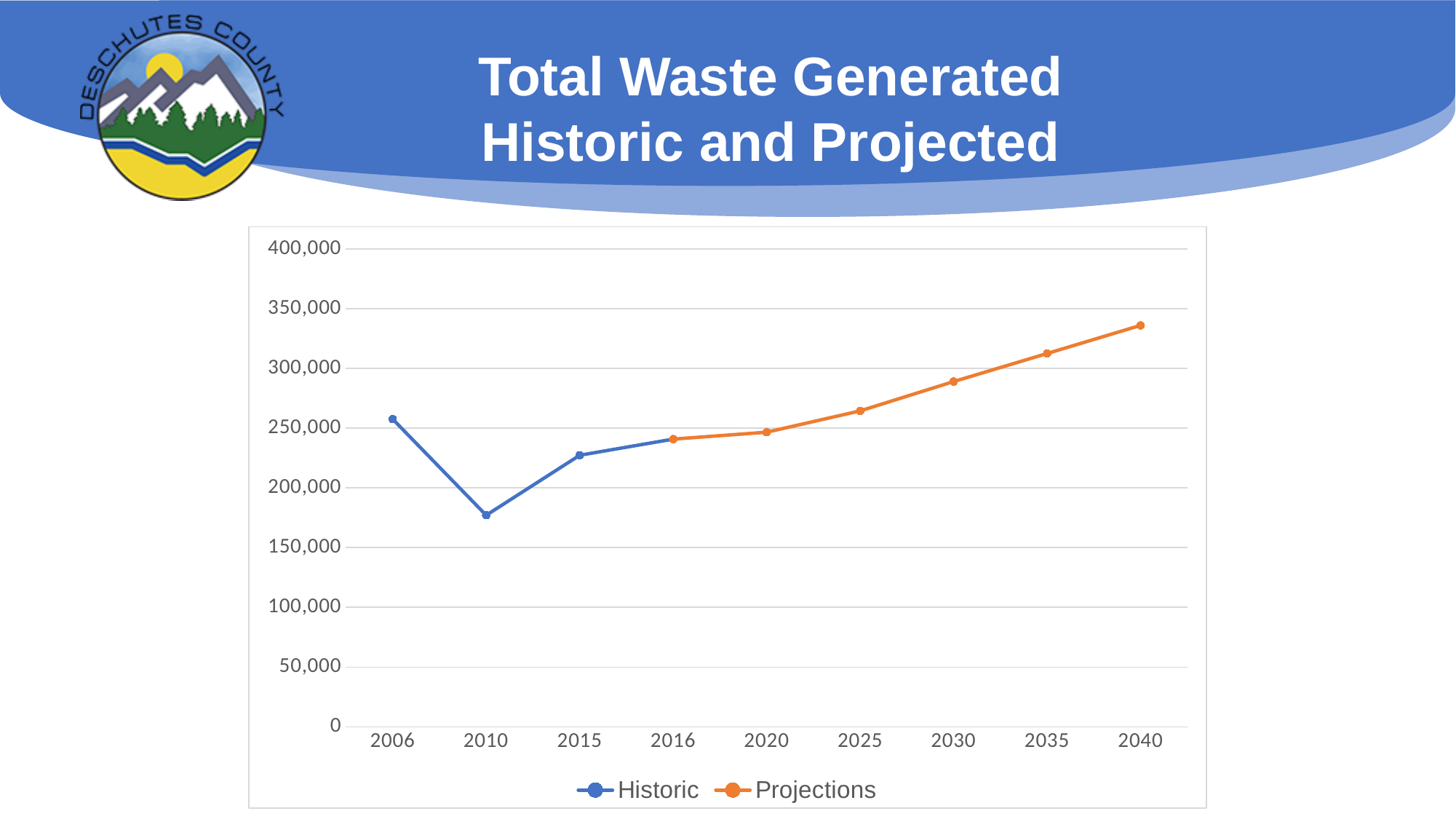
Is the value for 2010 greater or less than 200,000? less How many series does the legend list? 2 Which year has the lowest total waste generated? 2010 Is the value for 2006 greater or less than 250,000? greater How many years are labelled on the x axis? 9 Do the Projections values rise or fall from 2016 to 2040? rise Which year has the highest total waste generated? 2040 Is the value for 2030 greater or less than 300,000? less Which is larger, the value for 2006 or the value for 2015? 2006 What colour is the Projections line? orange What kind of chart is shown on the slide? line chart